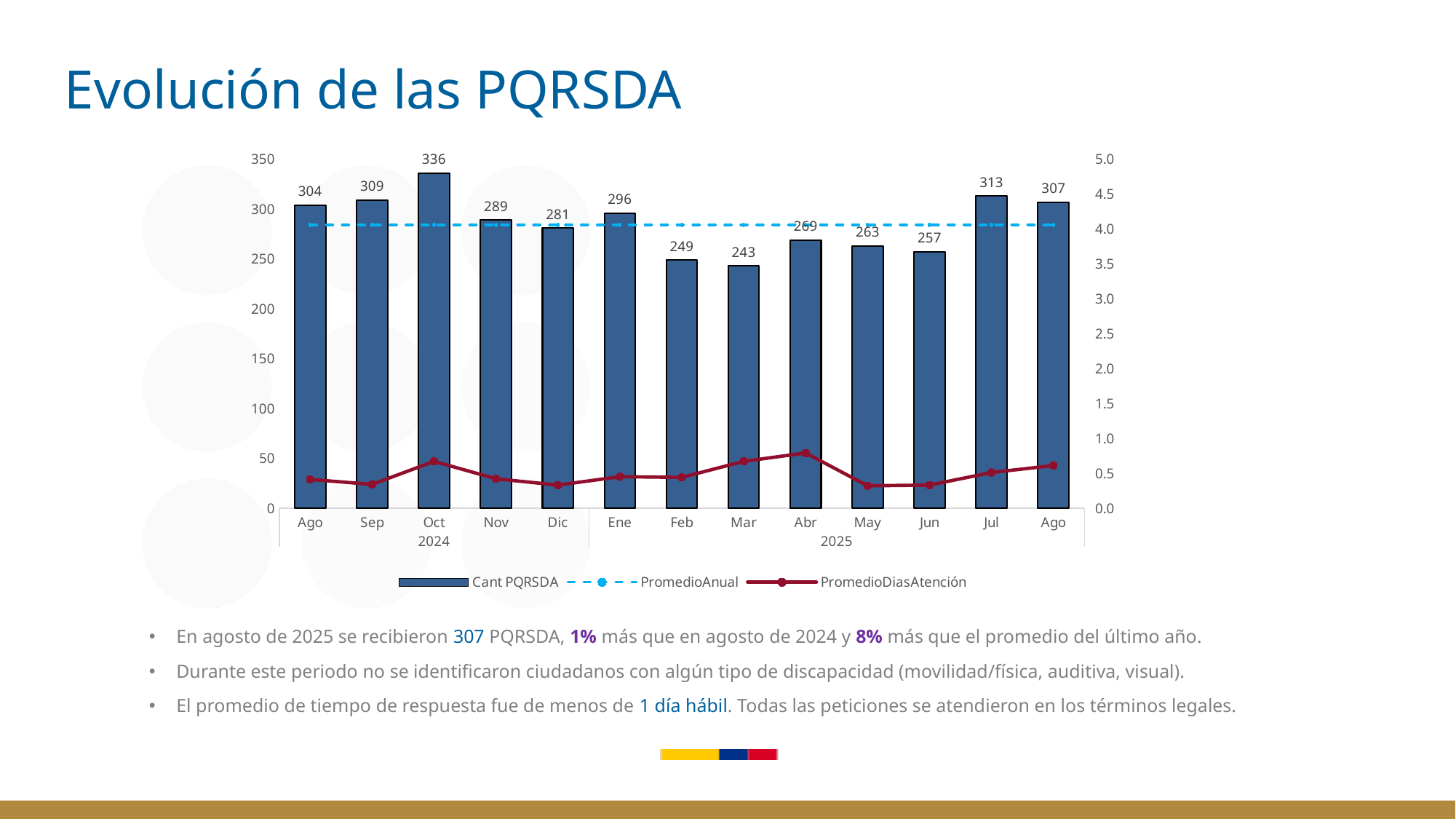
What is the title of the slide containing the chart? Evolución de las PQRSDA How many months are shown on the x axis? 13 What is the Cant PQRSDA value for Mar 2025? 243 What is the Cant PQRSDA value for Oct 2024? 336 Which is larger, the Cant PQRSDA value for Sep 2024 or for Ago 2025? Sep 2024 Which month has the highest Cant PQRSDA value? Oct 2024 Is the PromedioDiasAtención value for Abr 2025 greater or less than 1.0? less Do the Cant PQRSDA values rise or fall from Ene 2025 to Mar 2025? fall What kind of chart is used for the Cant PQRSDA series? bar chart Which month has the lowest Cant PQRSDA value? Mar 2025 What is the difference between the Cant PQRSDA values for Jul 2025 and Jun 2025? 56 How many series does the legend list? 3